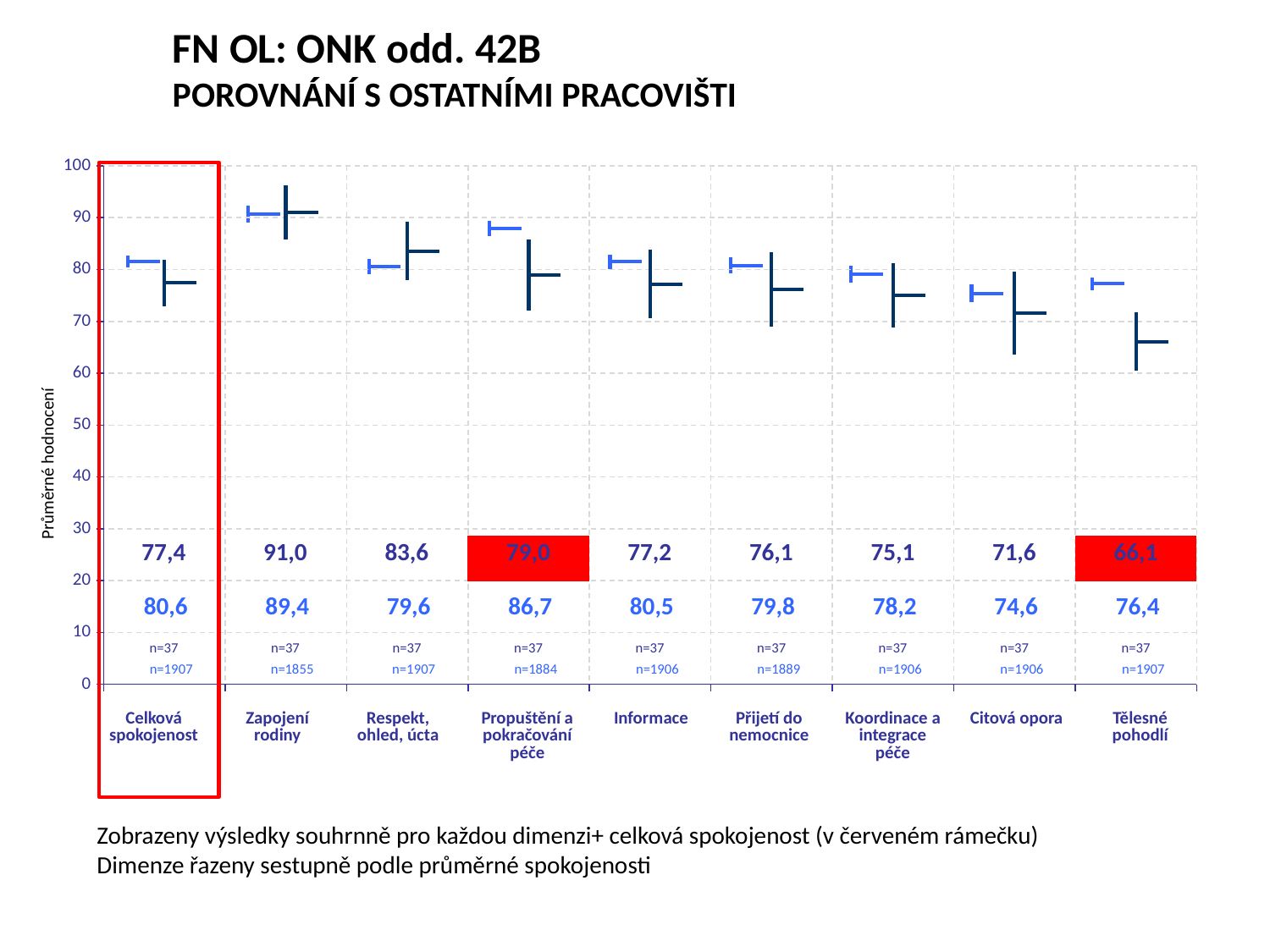
What is the label of the y axis? Průměrné hodnocení Do the dark blue values rise or fall from Zapojení rodiny to Tělesné pohodlí along the x axis? fall Which dimension has the lowest upper (dark blue) value? Tělesné pohodlí For Propuštění a pokračování péče, what is the difference between the light blue value (86,7) and the dark blue value (79,0)? 7,7 What is the sample size n shown for the department (first n line) in each category? n=37 For Celková spokojenost, which is larger: the dark blue value or the light blue value? the light blue value (80,6) What is the lower (light blue) value shown for Tělesné pohodlí? 76,4 For Tělesné pohodlí, what is the difference between the light blue value (76,4) and the dark blue value (66,1)? 10,3 Which dimension has the highest upper (dark blue) value? Zapojení rodiny What is the upper (dark blue) value shown for Zapojení rodiny? 91,0 Which category is enclosed in the red frame? Celková spokojenost How many categories are shown along the x axis? 9